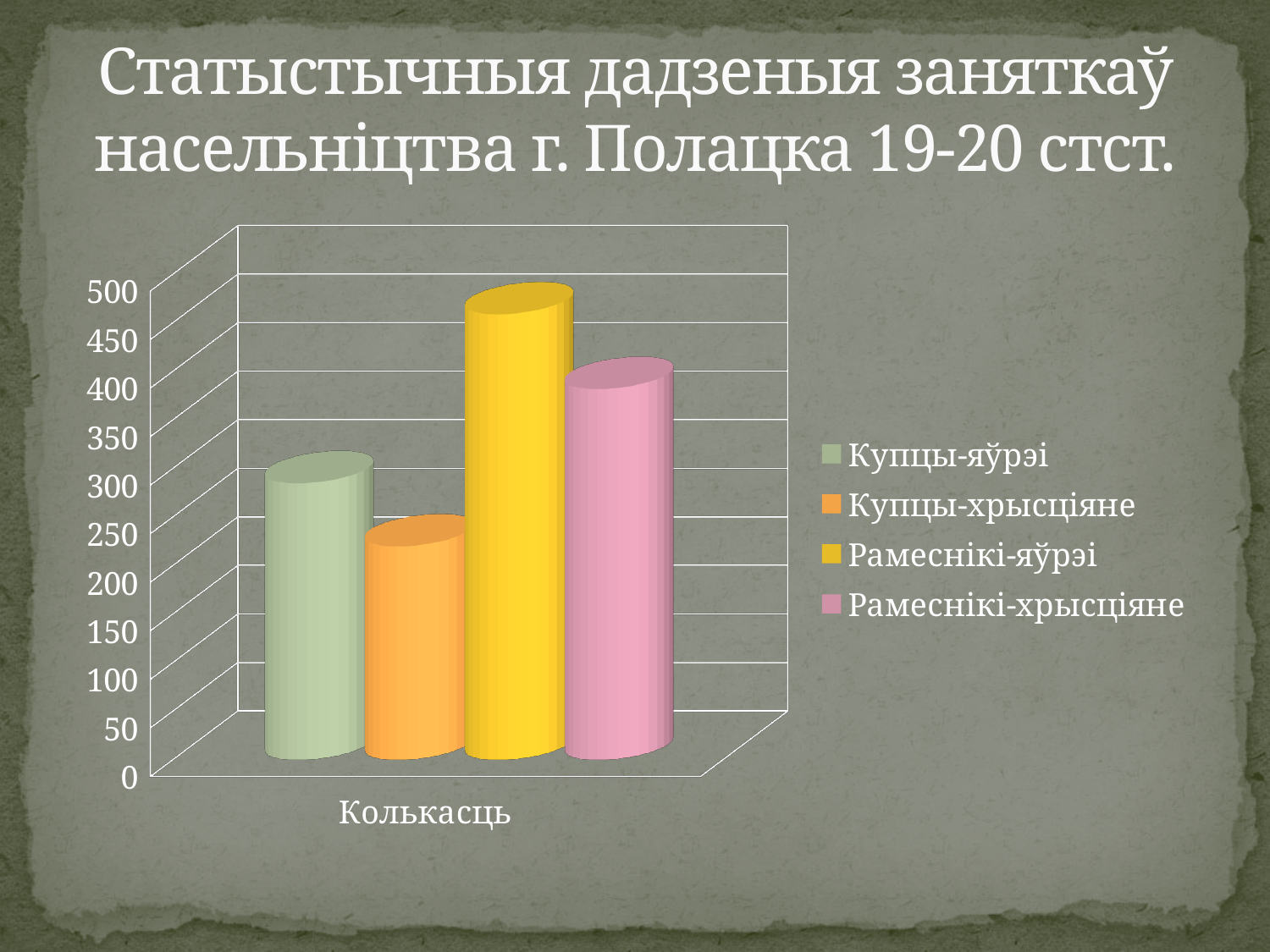
Is the value for Купцы-яўрэі greater or less than 250? greater Which is larger, the value for Рамеснікі-хрысціяне or the value for Купцы-яўрэі? Рамеснікі-хрысціяне What kind of chart is shown on the slide? bar chart Which series has the lowest value? Купцы-хрысціяне How many series does the legend list? 4 Which series has the highest value? Рамеснікі-яўрэі Is the value for Купцы-хрысціяне greater or less than 300? less Is the value for Рамеснікі-хрысціяне greater or less than 350? greater Which is larger, the value for Купцы-яўрэі or the value for Купцы-хрысціяне? Купцы-яўрэі What is the category label shown on the x axis? Колькасць What colour is the bar for Рамеснікі-яўрэі? yellow